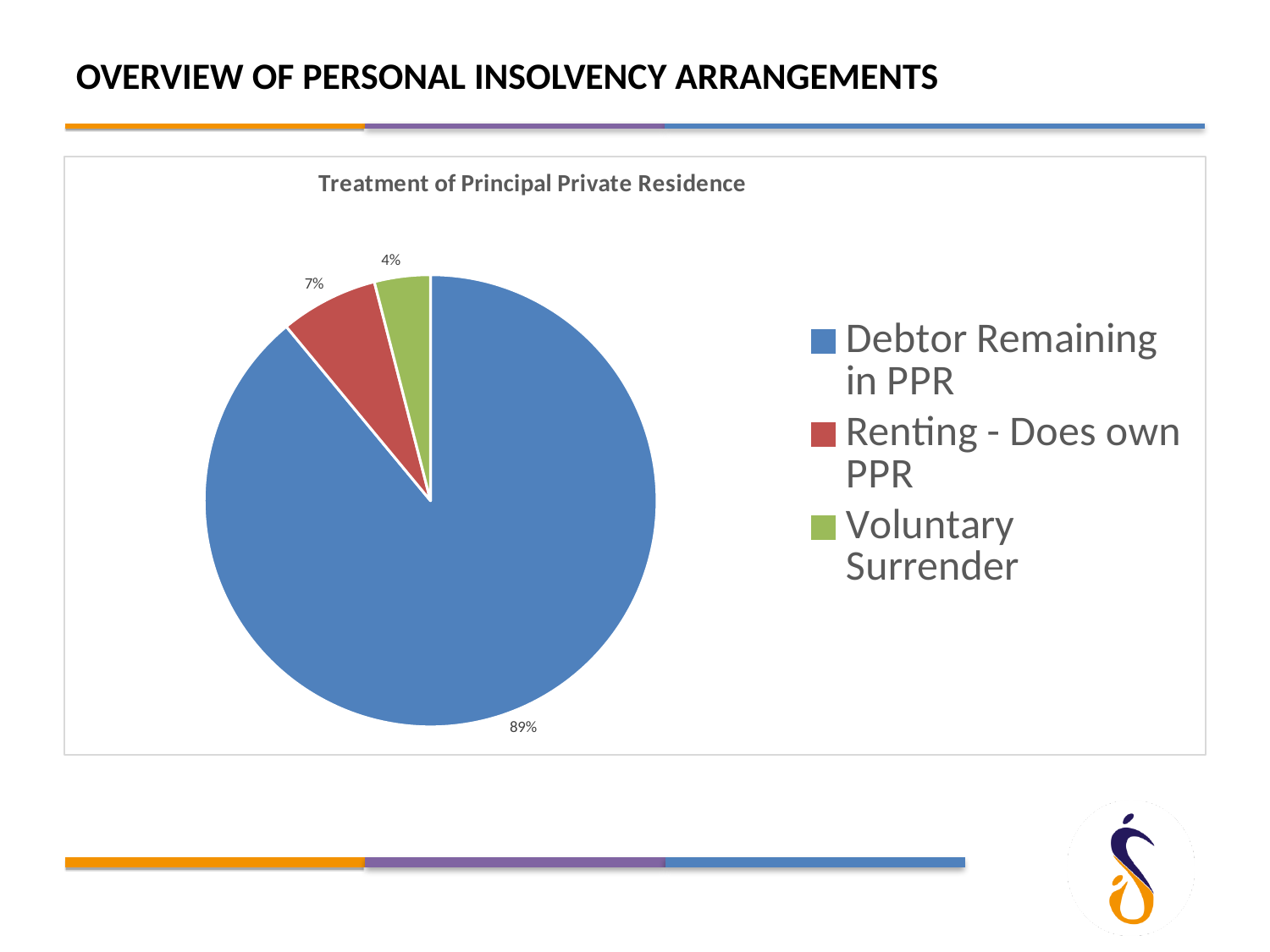
What is the difference in percentage points between Renting - Does own PPR and Voluntary Surrender? 3 Which category has the smallest share of the pie? Voluntary Surrender What is the difference in percentage points between Debtor Remaining in PPR and Renting - Does own PPR? 82 What share of the pie is Debtor Remaining in PPR? 89% What colour is the slice for Voluntary Surrender? green What type of chart is shown on the slide? pie chart What share of the pie is Renting - Does own PPR? 7% What share of the pie is Voluntary Surrender? 4% How many categories does the pie chart show? 3 Which is larger, the share for Renting - Does own PPR or the share for Voluntary Surrender? Renting - Does own PPR Which category has the largest share of the pie? Debtor Remaining in PPR What is the title of the chart? Treatment of Principal Private Residence